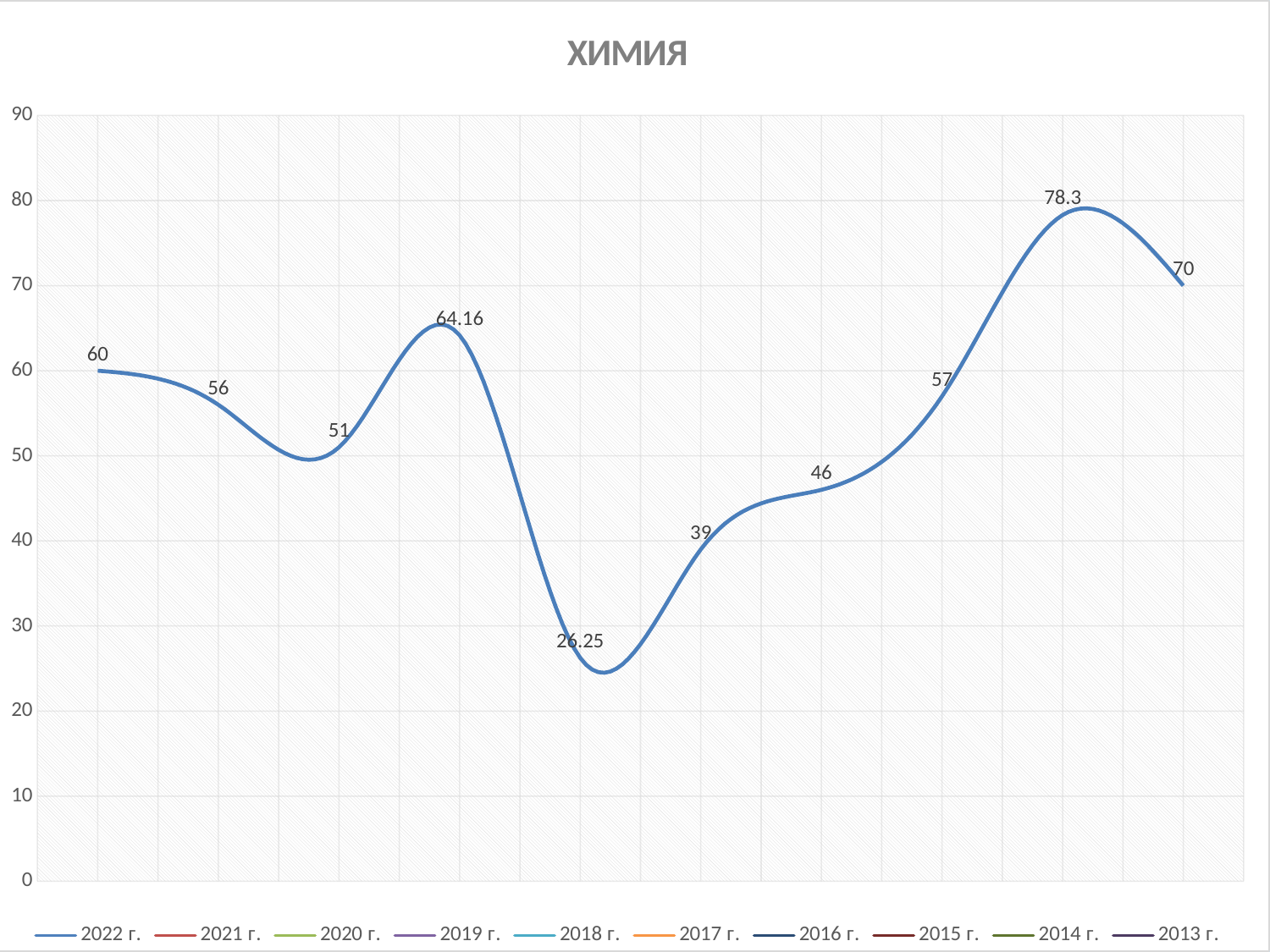
What is the value of the last (rightmost) point on the line? 70 What is the lowest value labelled on the line? 26.25 What is the first entry in the legend? 2022 г. What kind of chart is shown on the slide? line chart How many data points are labelled on the line? 10 Does the line end higher or lower than it starts? higher What is the value of the first (leftmost) point on the line? 60 What is the difference between the highest and lowest labelled values on the line? 52.05 What is the title of the chart? ХИМИЯ How many series does the legend list? 10 Which is larger, the first point on the line (60) or the last point (70)? the last point (70) What is the highest value labelled on the line? 78.3